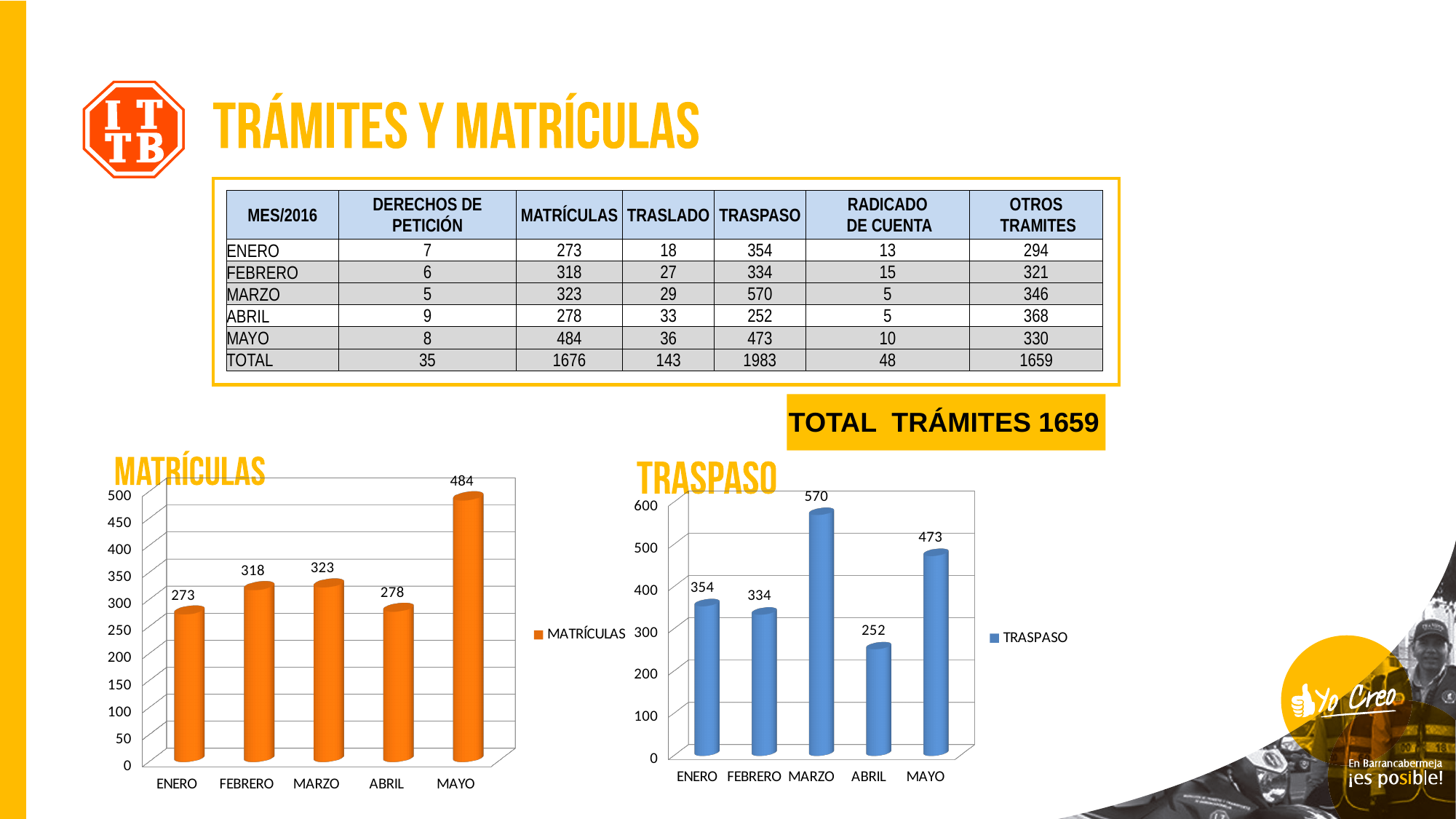
In the TRASPASO chart, what is the value for ABRIL? 252 In the TRASPASO chart, which month has the highest value? MARZO In the TRASPASO chart, which is larger, ENERO or FEBRERO? ENERO In the MATRÍCULAS chart, what is the legend entry? MATRÍCULAS In the MATRÍCULAS chart, how many months are shown on the x axis? 5 In the MATRÍCULAS chart, what kind of chart is used? Bar chart In the MATRÍCULAS chart, what is the difference between MARZO and FEBRERO? 5 In the MATRÍCULAS chart, what is the value for MAYO? 484 In the TRASPASO chart, how many series does the legend list? 1 In the TRASPASO chart, what is the difference between MARZO and ABRIL? 318 In the TRASPASO chart, what colour are the bars? Blue In the MATRÍCULAS chart, which month has the lowest value? ENERO